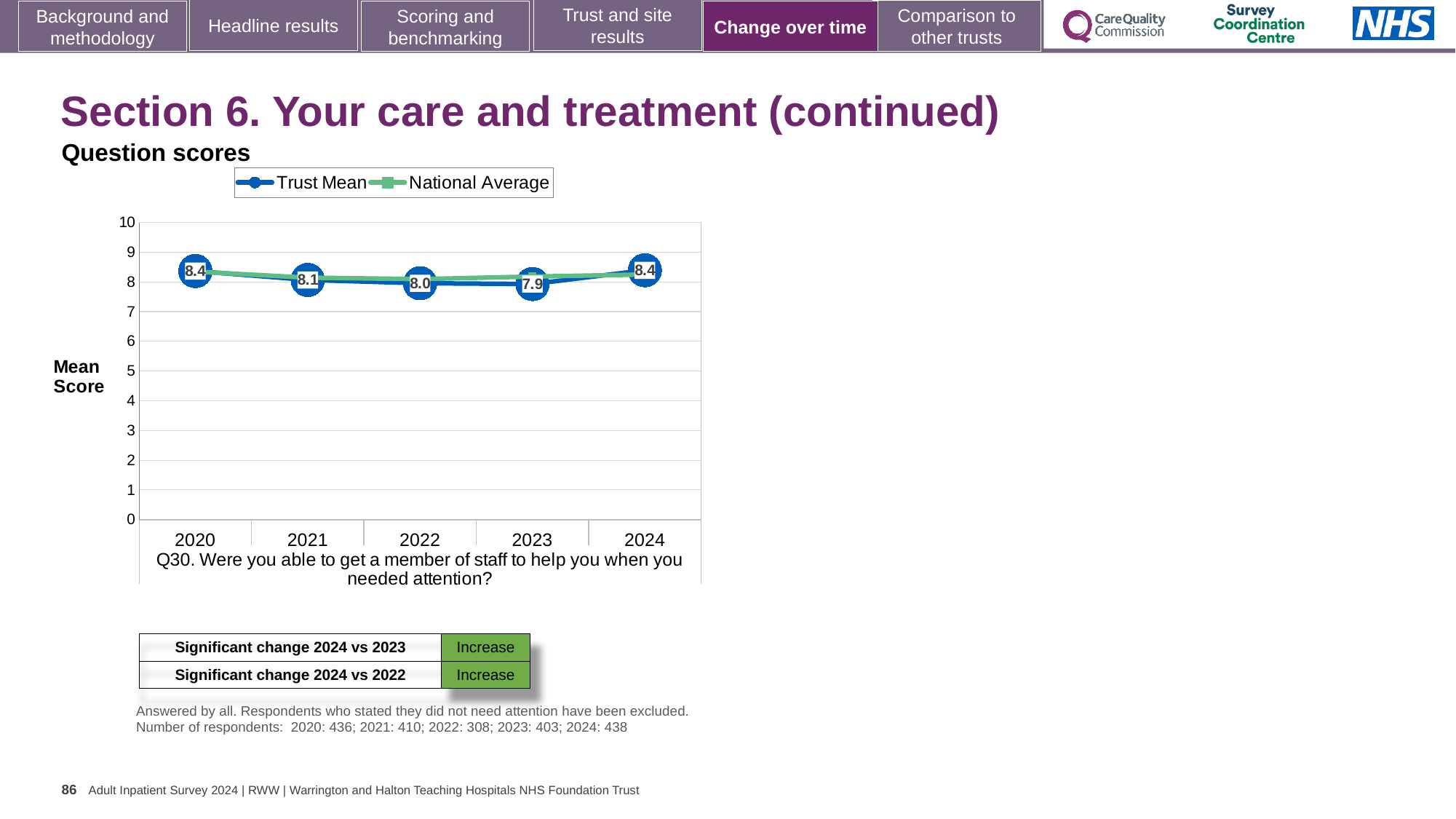
What is the difference between the Trust Mean score in 2024 and in 2023? 0.5 Which is larger, the Trust Mean score for 2020 or for 2021? 2020 How many years are plotted on the x axis? 5 In which year is the Trust Mean score lowest? 2023 What is the Trust Mean score for 2020? 8.4 What is the Trust Mean score for 2023? 7.9 Is the National Average value for 2022 greater or less than 7? greater What is the Trust Mean score for 2024? 8.4 Does the Trust Mean score rise or fall from 2020 to 2023? fall What kind of chart is shown? line chart How many series does the legend list? 2 What is the Trust Mean score for 2022? 8.0